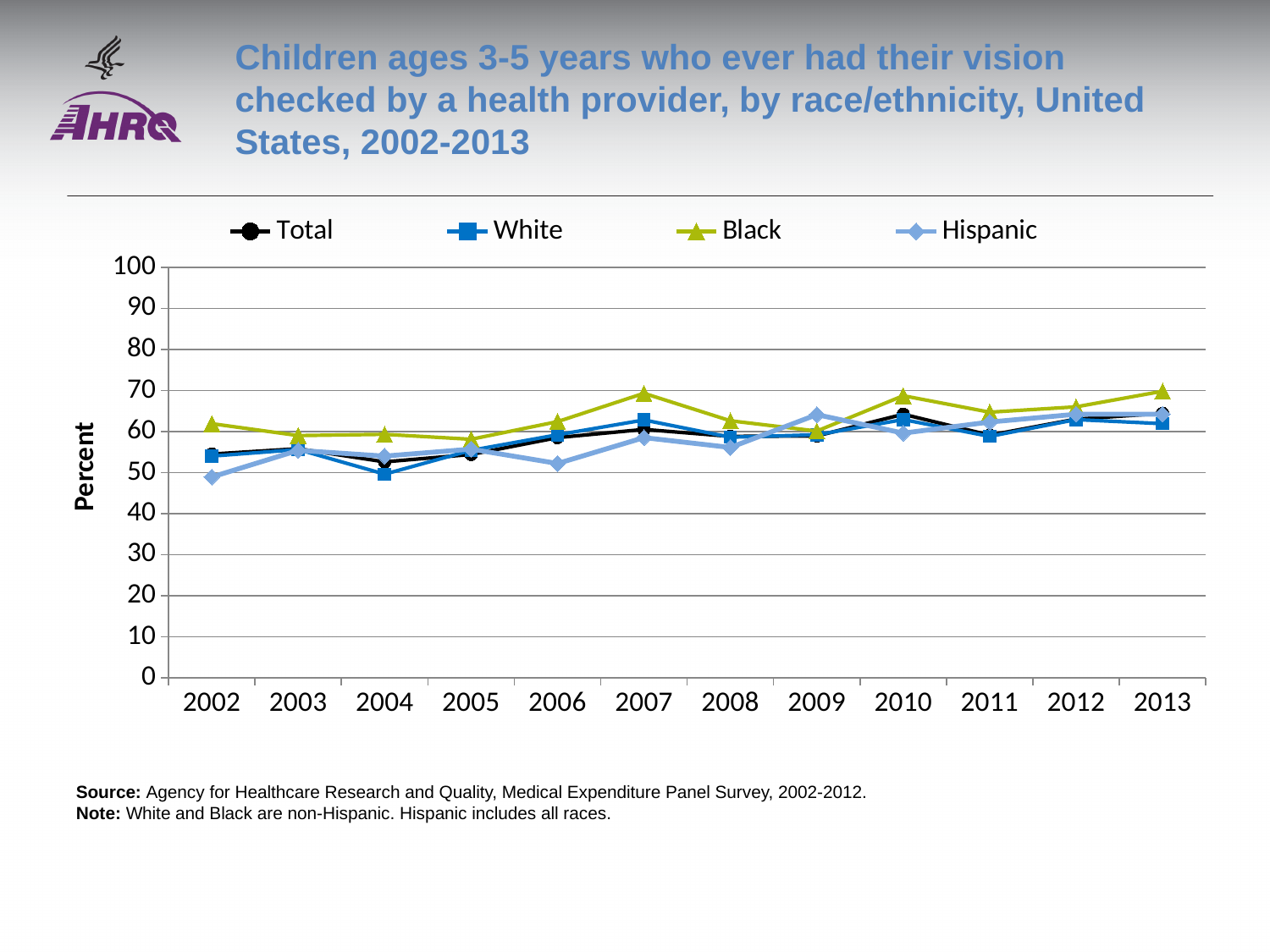
Which series has the highest value in 2007? Black What is the label on the y axis? Percent Does the Total series rise or fall overall from 2002 to 2013? rise How many years are plotted along the x axis? 12 What kind of chart is shown on the slide? line chart Is the value for Black in 2007 greater or less than 60? greater Is the value for Black in 2013 greater or less than 60? greater Which series has the lowest value in 2002? Hispanic In 2002, which is larger, the value for Black or the value for Hispanic? Black Is the value for Total in 2010 greater or less than 60? greater How many series does the legend list? 4